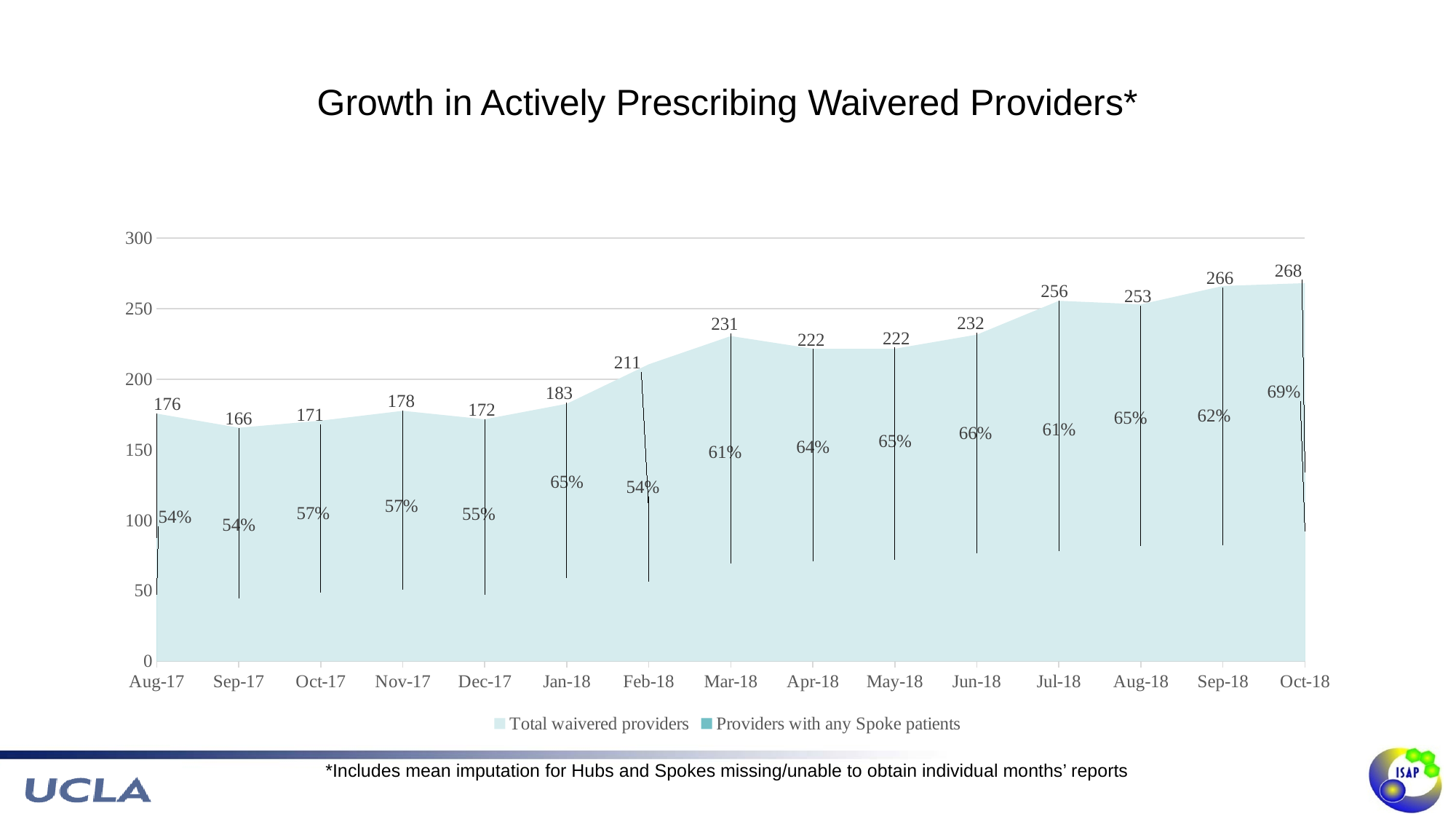
What is the difference in Total waivered providers between Oct-18 and Aug-17? 92 Which month has the highest value for Total waivered providers? Oct-18 What kind of chart is this? area chart Is the value for Total waivered providers in Mar-18 greater or less than 200? greater How many months are shown on the x axis? 15 Which is larger, the Total waivered providers value for Jul-18 or for Aug-18? Jul-18 What percentage label is shown for Providers with any Spoke patients in Jun-18? 66% What is the value for Total waivered providers in Feb-18? 211 Do the Total waivered providers values generally rise or fall from Aug-17 to Oct-18? rise What is the value for Total waivered providers in Oct-18? 268 How many series does the legend list? 2 Which month has the lowest value for Total waivered providers? Sep-17